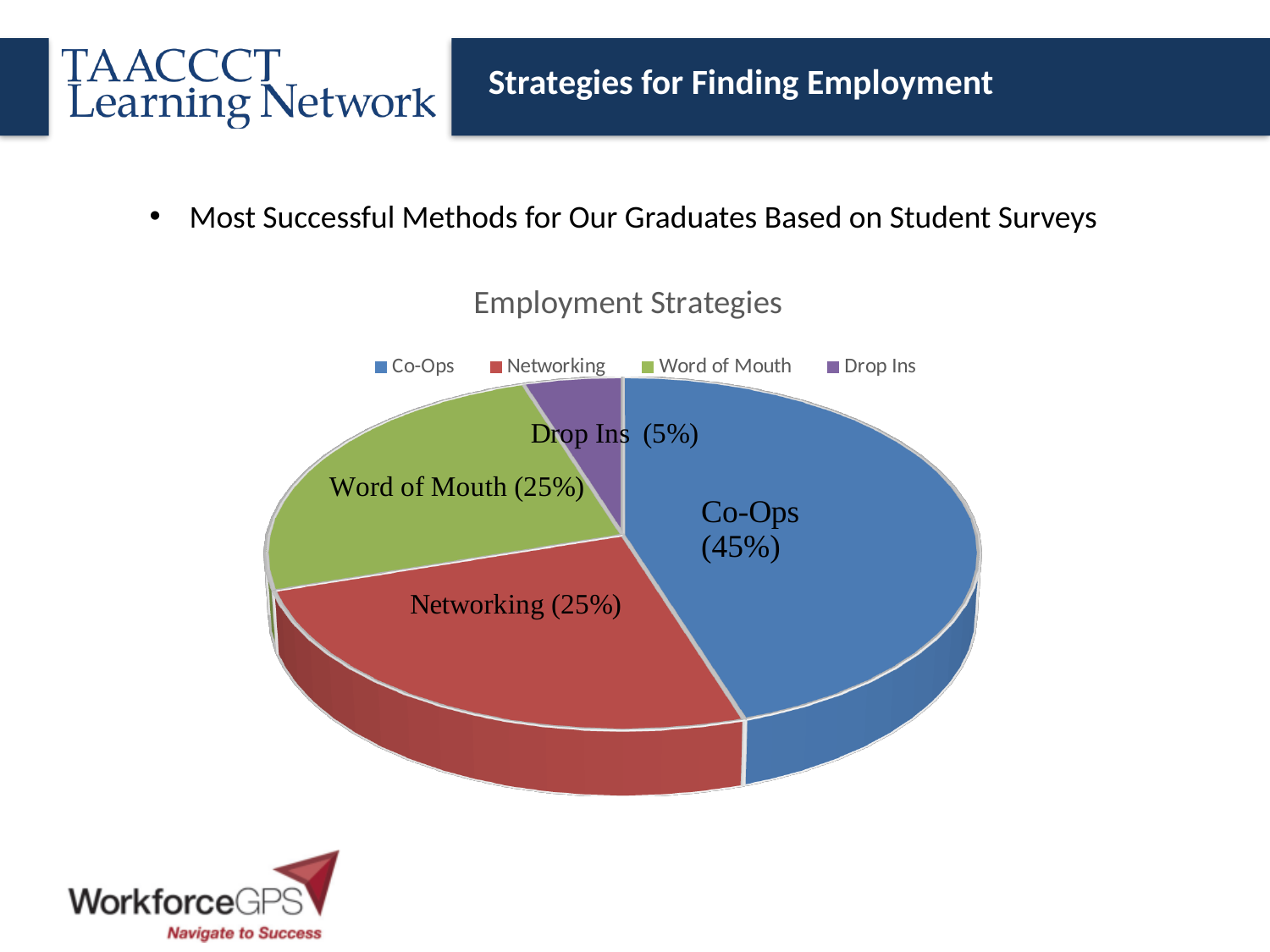
Which employment strategy has the largest slice of the pie? Co-Ops What kind of chart is shown on the slide? pie chart What share of the pie does Networking represent? 25% What share of the pie does Drop Ins represent? 5% What is the title of the chart? Employment Strategies What share of the pie does Word of Mouth represent? 25% Which employment strategy has the smallest slice of the pie? Drop Ins What is the difference in percentage points between Co-Ops and Drop Ins? 40 How many entries does the legend list? 4 How many slices does the pie chart have? 4 Which is larger, the share for Co-Ops or the share for Networking? Co-Ops